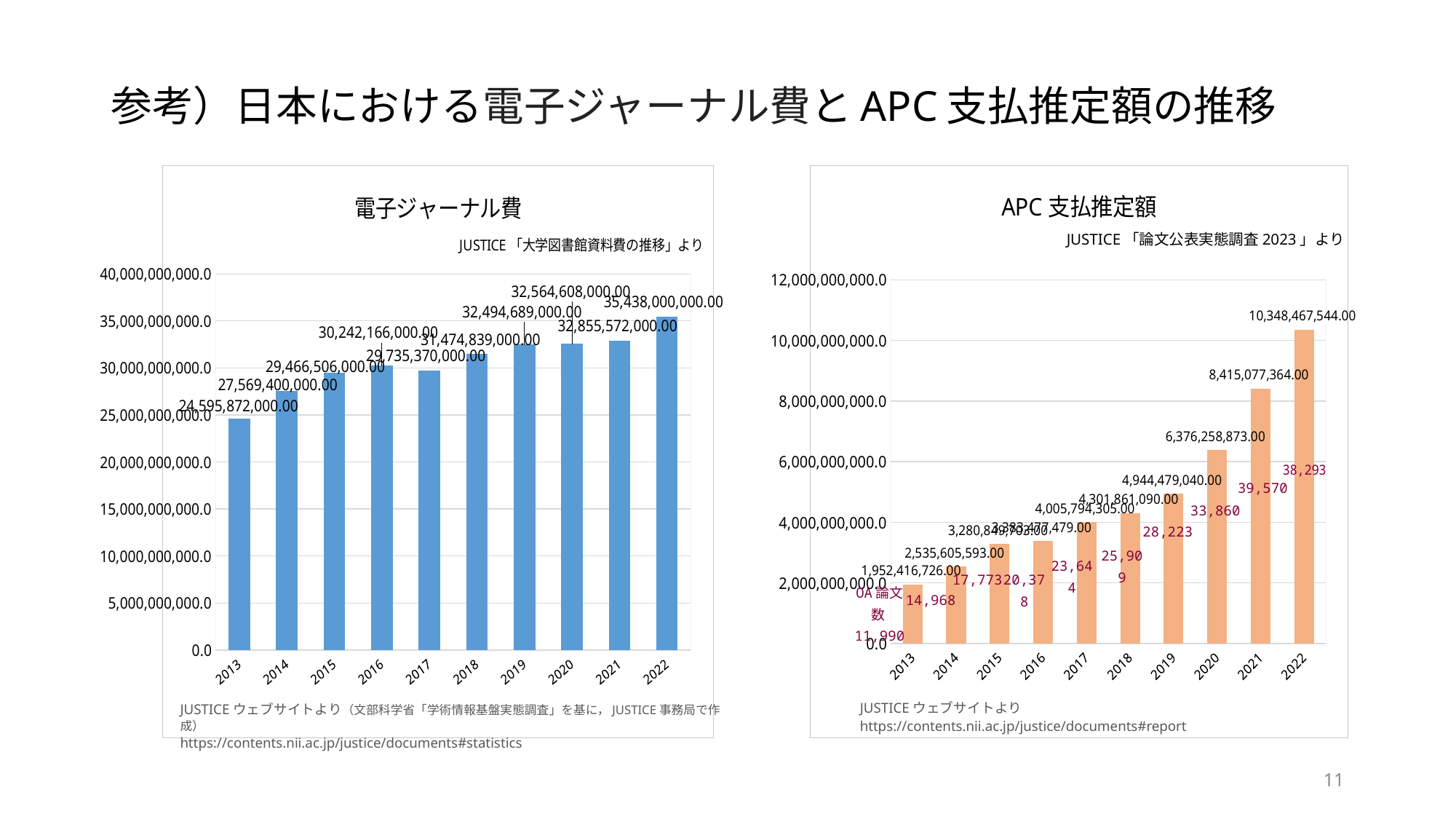
In the 電子ジャーナル費 chart on the left, is the value for 2017 greater or less than 30,000,000,000.0? less What kind of chart is the APC 支払推定額 chart on the right? bar chart In the 電子ジャーナル費 chart on the left, which year has the highest value? 2022 In the APC 支払推定額 chart on the right, what is the difference between the 2022 and 2021 values? 1,933,390,180.00 In the 電子ジャーナル費 chart on the left, which year has the lowest value? 2013 In the APC 支払推定額 chart on the right, what is the value for 2022? 10,348,467,544.00 In the APC 支払推定額 chart on the right, what is the value for 2021? 8,415,077,364.00 In the 電子ジャーナル費 chart on the left, how many years are shown on the x axis? 10 In the 電子ジャーナル費 chart on the left, what is the value for 2013? 24,595,872,000.00 In the 電子ジャーナル費 chart on the left, what is the value for 2022? 35,438,000,000.00 In the APC 支払推定額 chart on the right, what is the value for 2013? 1,952,416,726.00 In the APC 支払推定額 chart on the right, do the values generally rise or fall from 2013 to 2022? rise